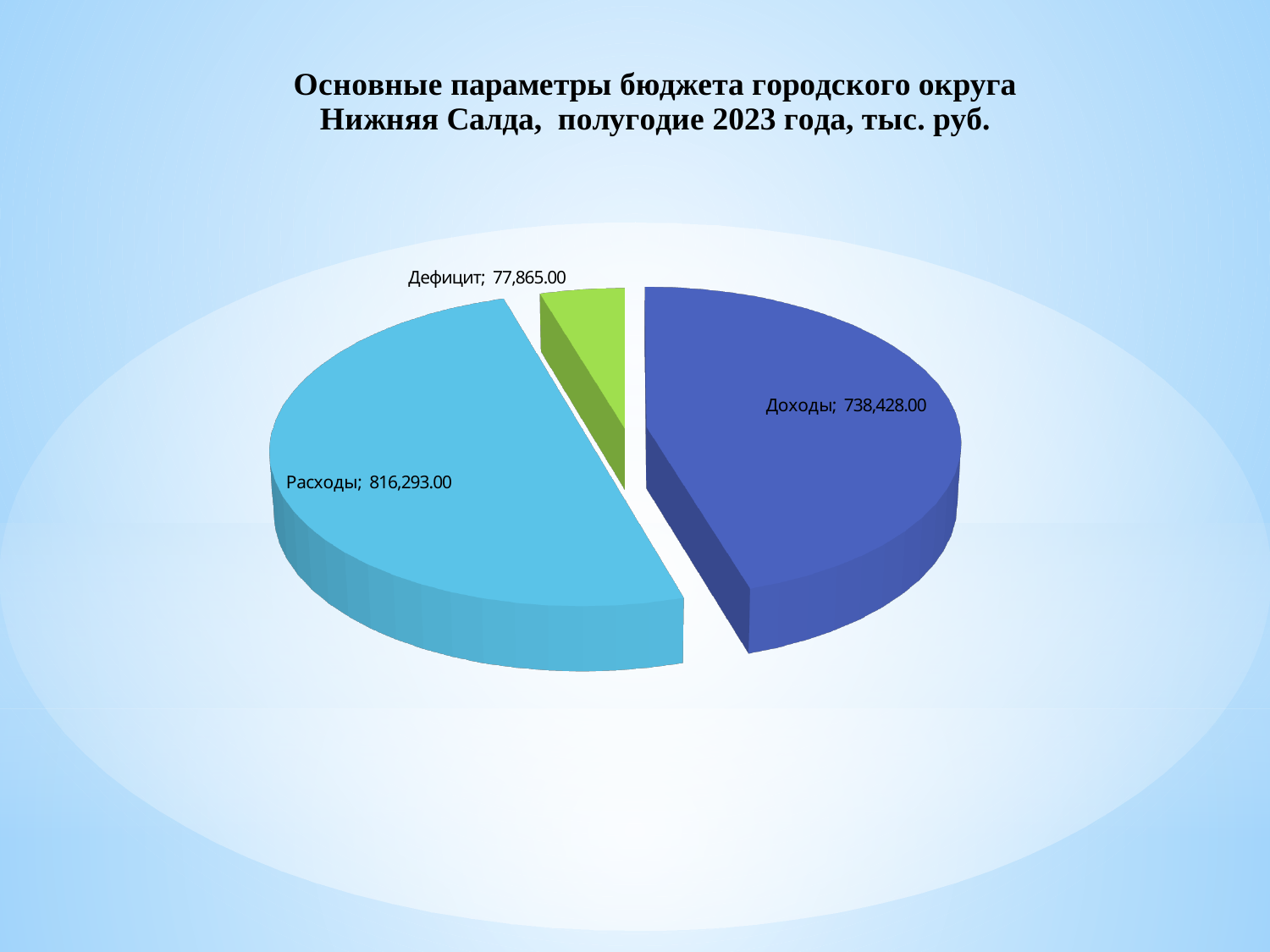
What is the value for Дефицит? 77,865.00 Which category has the smallest value? Дефицит Which is larger, Доходы or Расходы? Расходы What is the value for Расходы? 816,293.00 Which category has the largest value? Расходы What is the value for Доходы? 738,428.00 What is the difference between Доходы and Дефицит? 660,563.00 How many slices does the pie chart have? 3 What colour is the Дефицит slice? green What is the difference between Расходы and Доходы? 77,865.00 What share of the pie does the Расходы slice represent? 50% What type of chart is shown on the slide? pie chart